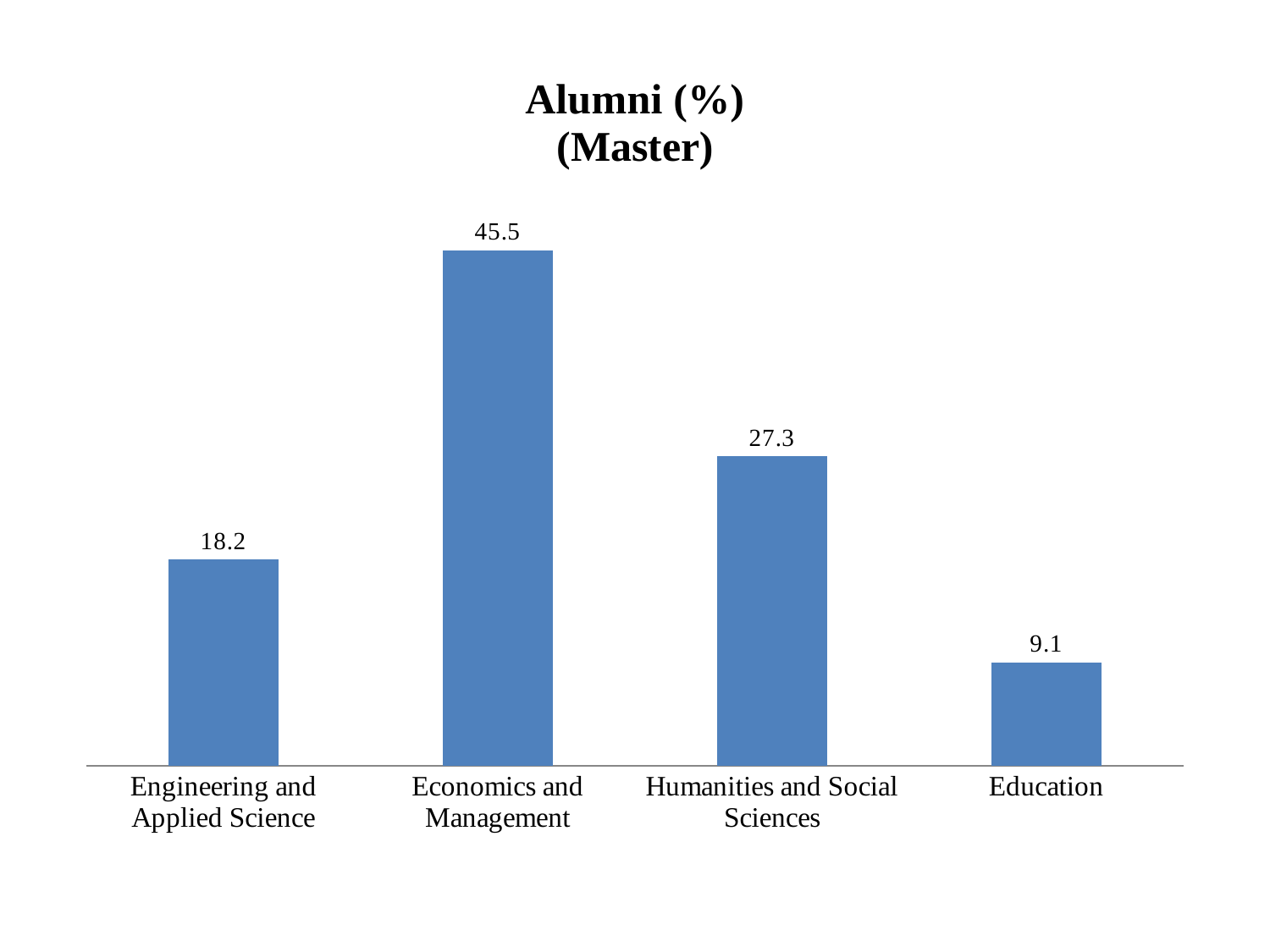
What is the value for Humanities and Social Sciences? 27.3 What is the difference between the values for Engineering and Applied Science and Education? 9.1 What kind of chart is shown on the slide? Bar chart What is the value for Economics and Management? 45.5 What is the difference between the values for Economics and Management and Humanities and Social Sciences? 18.2 What is the value for Education? 9.1 Which category has the lowest value? Education How many categories are shown in the chart? 4 What is the title of the chart? Alumni (%) (Master) Which category has the highest value? Economics and Management Which is larger, the value for Humanities and Social Sciences or the value for Engineering and Applied Science? Humanities and Social Sciences What is the value for Engineering and Applied Science? 18.2